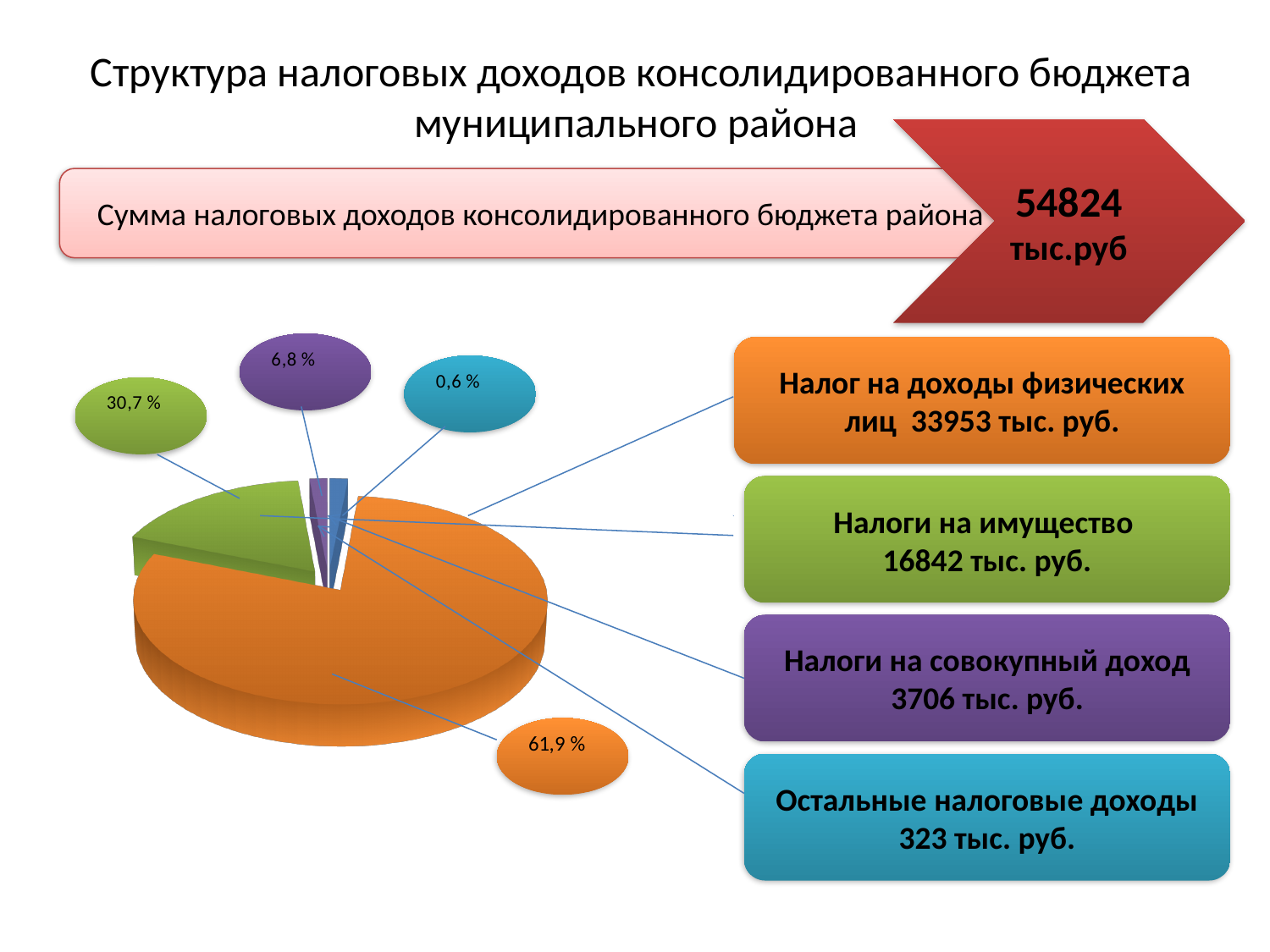
What kind of chart is shown on the slide? pie chart What is the difference in percentage points between the shares of Налог на доходы физических лиц and Налоги на имущество? 31,2 % Which is larger: Налоги на совокупный доход or Остальные налоговые доходы? Налоги на совокупный доход What share of the pie does the green slice (Налоги на имущество) represent? 30,7 % What colour is the slice for Налоги на совокупный доход? purple Which category has the largest share of the pie? Налог на доходы физических лиц What share of the pie does the orange slice (Налог на доходы физических лиц) represent? 61,9 % What share of the pie does the blue slice (Остальные налоговые доходы) represent? 0,6 % How many slices does the pie chart have? 4 Which category has the smallest share of the pie? Остальные налоговые доходы What is the value for Налоги на имущество in тыс. руб.? 16842 тыс. руб.